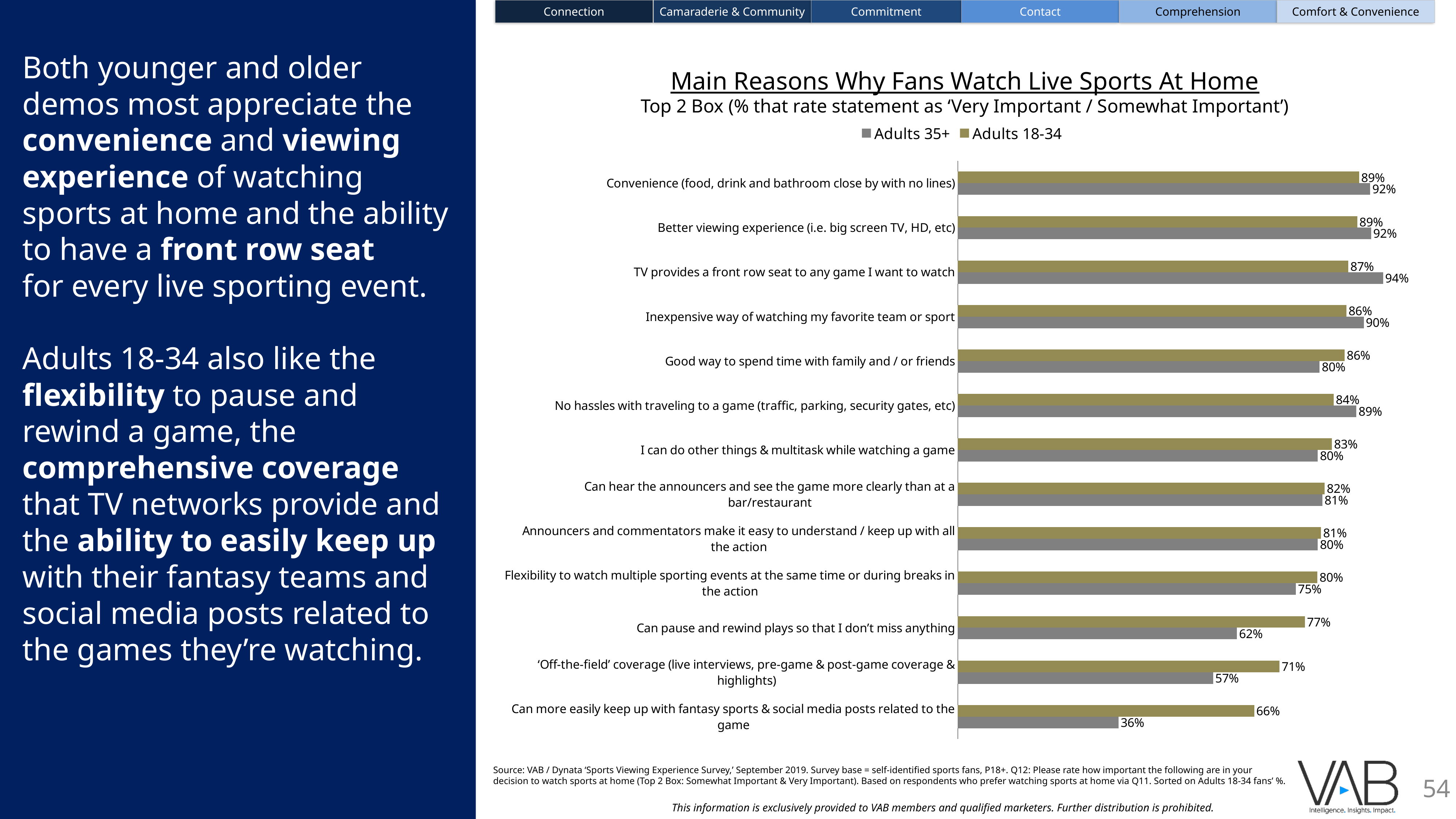
What percentage of Adults 18-34 rate 'Can pause and rewind plays so that I don't miss anything' as important? 77% What percentage of Adults 35+ rate 'Can more easily keep up with fantasy sports & social media posts related to the game' as important? 36% How many series does the legend list? 2 Which reason has the highest value for Adults 35+? TV provides a front row seat to any game I want to watch What type of chart is shown on the slide? Bar chart Which colour represents Adults 18-34 in the chart? Gold What is the difference between Adults 18-34 and Adults 35+ for 'Can more easily keep up with fantasy sports & social media posts related to the game'? 30 percentage points How many reasons (categories) are plotted in the chart? 13 What is the Adults 35+ value for 'TV provides a front row seat to any game I want to watch'? 94% For 'Off-the-field coverage (live interviews, pre-game & post-game coverage & highlights)', which group has the larger value, Adults 18-34 or Adults 35+? Adults 18-34 What is the difference between Adults 35+ and Adults 18-34 for 'Inexpensive way of watching my favorite team or sport'? 4 percentage points Which reason has the lowest value for Adults 35+? Can more easily keep up with fantasy sports & social media posts related to the game